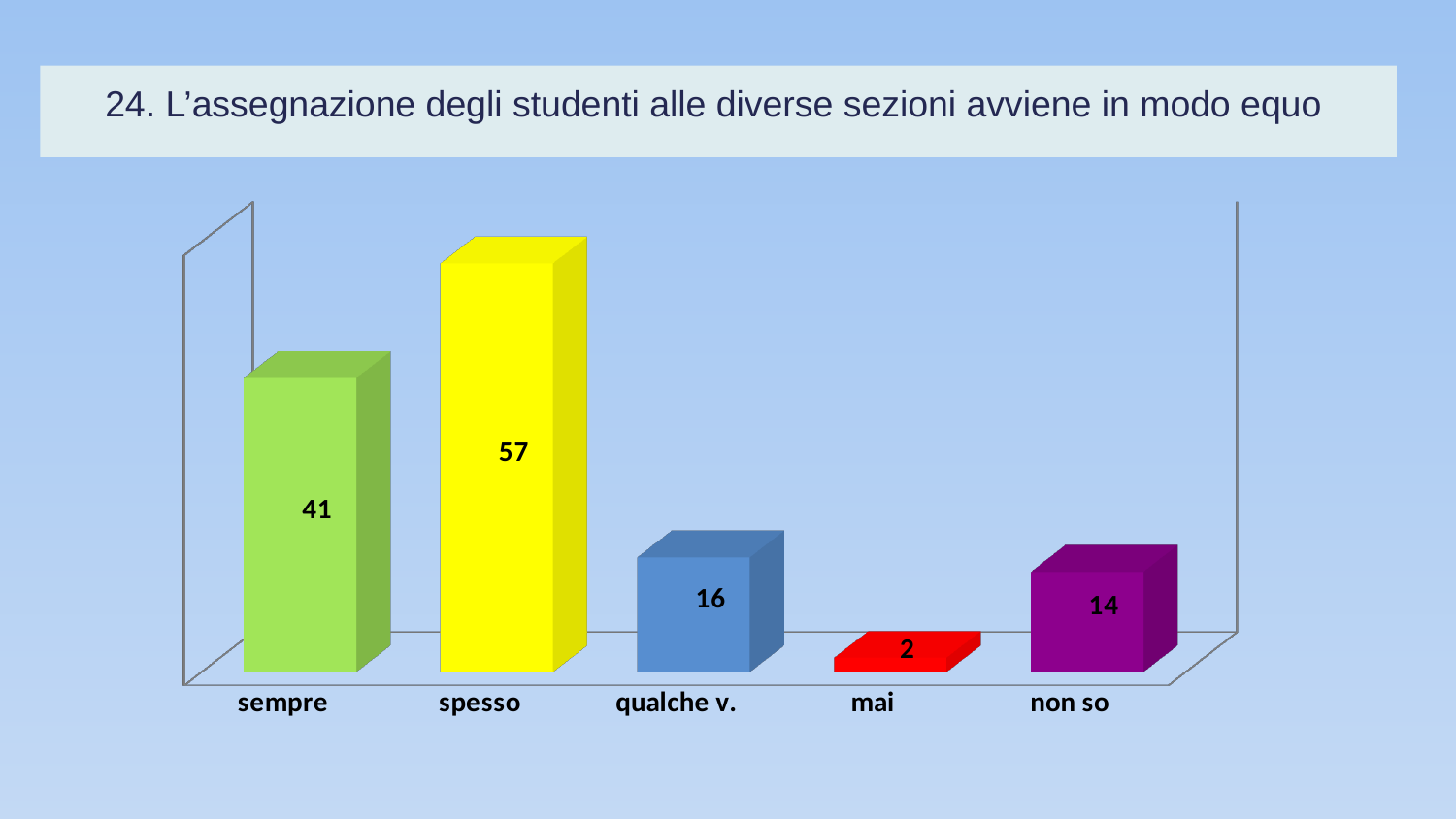
What is the difference between the values for "spesso" and "sempre"? 16 What is the value for "spesso"? 57 Which category has the highest value? spesso What is the value for "qualche v."? 16 What kind of chart is shown on the slide? bar chart What is the value for "mai"? 2 How many categories are shown on the x axis? 5 What is the value for "sempre"? 41 Which is larger, the value for "qualche v." or the value for "non so"? qualche v. What colour is the bar for "mai"? red What is the value for "non so"? 14 Which category has the lowest value? mai